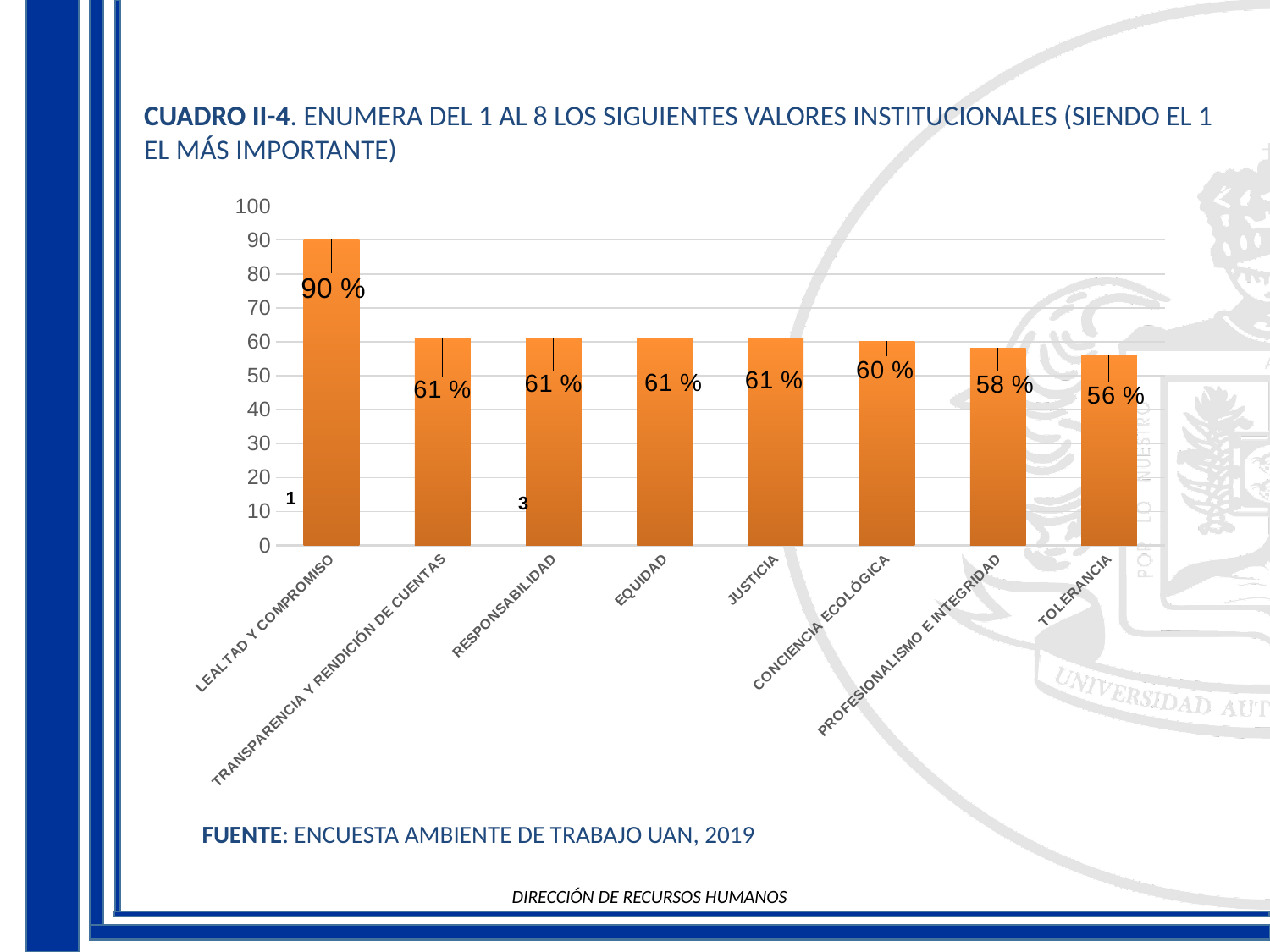
What is the value for TOLERANCIA? 56 % Which category has the lowest value? TOLERANCIA What is the value for CONCIENCIA ECOLÓGICA? 60 % What is the value for LEALTAD Y COMPROMISO? 90 % What source is cited below the chart? ENCUESTA AMBIENTE DE TRABAJO UAN, 2019 What is the value for PROFESIONALISMO E INTEGRIDAD? 58 % How many categories are shown on the x axis? 8 What kind of chart is shown on the slide? bar chart Is the value for LEALTAD Y COMPROMISO greater or less than 80? greater What is the difference between the values for LEALTAD Y COMPROMISO and TOLERANCIA? 34 percentage points Which is larger, the value for PROFESIONALISMO E INTEGRIDAD or the value for TOLERANCIA? PROFESIONALISMO E INTEGRIDAD Which category has the highest value? LEALTAD Y COMPROMISO